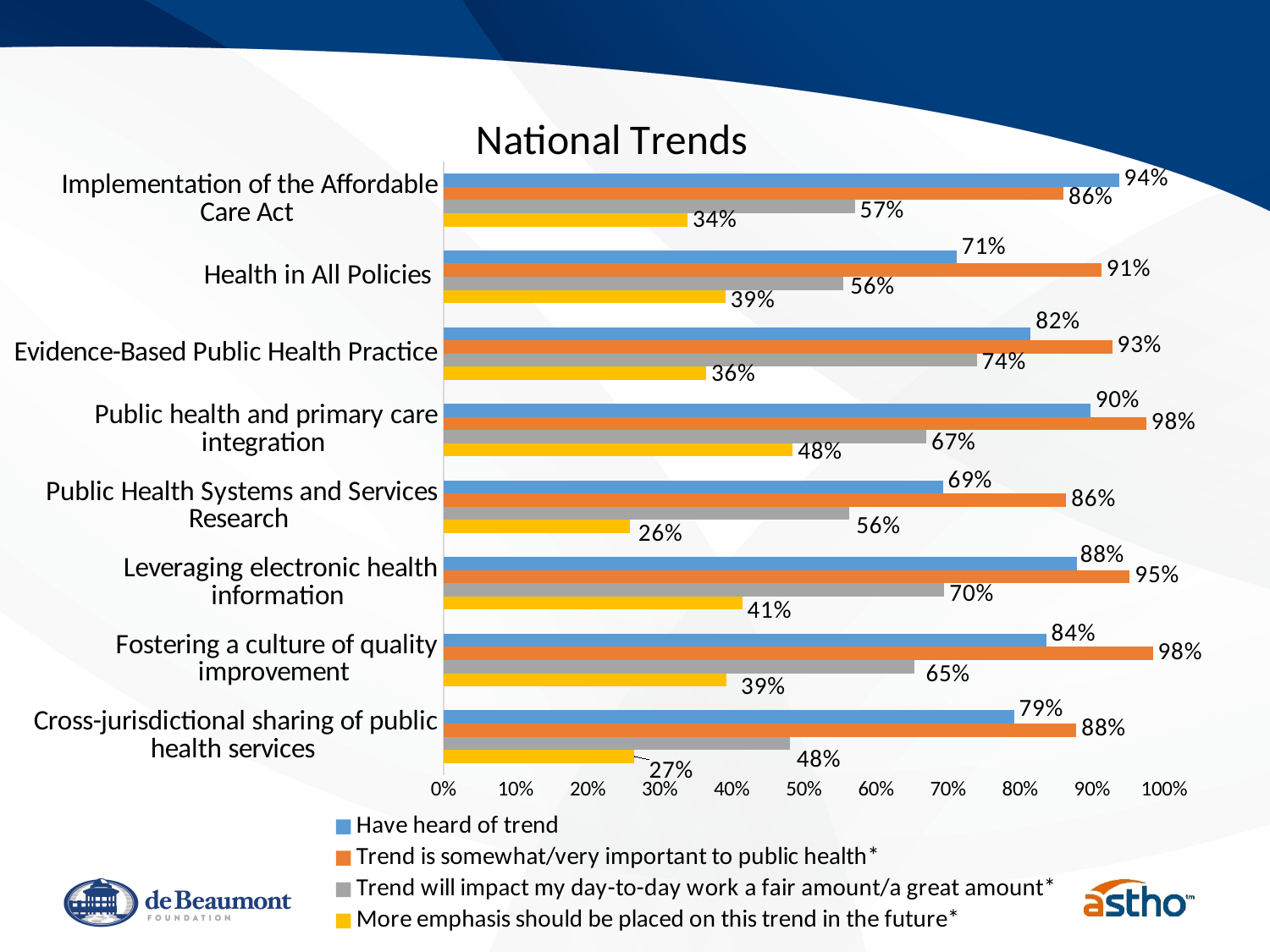
What is the title of the chart? National Trends How many trends (categories) are shown on the chart? 8 How many series does the legend list? 4 What percentage of respondents have heard of the trend 'Implementation of the Affordable Care Act'? 94% Which trend has the lowest value for 'More emphasis should be placed on this trend in the future'? Public Health Systems and Services Research Which trend has the highest value for 'Have heard of trend'? Implementation of the Affordable Care Act Which has a higher value for 'Trend will impact my day-to-day work': Evidence-Based Public Health Practice or Leveraging electronic health information? Evidence-Based Public Health Practice For Health in All Policies, what is the difference between 'Trend is somewhat/very important to public health' and 'Have heard of trend'? 20 percentage points Which trend has the highest value for 'Trend will impact my day-to-day work a fair amount/a great amount'? Evidence-Based Public Health Practice What is the value for 'Trend is somewhat/very important to public health' for Fostering a culture of quality improvement? 98% What is the value for 'More emphasis should be placed on this trend in the future' for Public Health Systems and Services Research? 26% What type of chart is shown on the slide? Bar chart